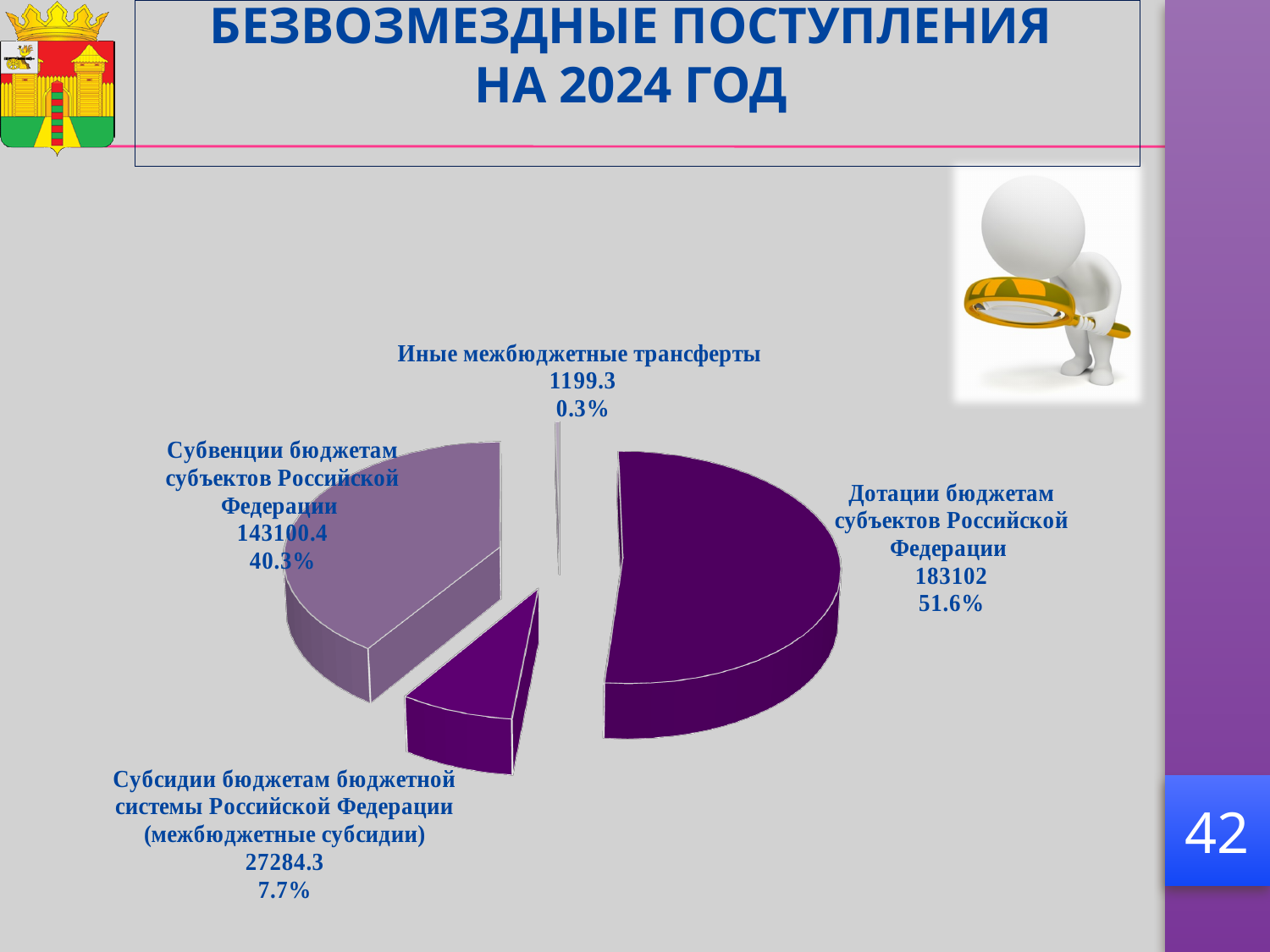
What kind of chart is shown on the slide? Pie chart Which is larger: the value for Субсидии бюджетам бюджетной системы Российской Федерации (межбюджетные субсидии) or the value for Иные межбюджетные трансферты? Субсидии бюджетам бюджетной системы Российской Федерации (межбюджетные субсидии) What share of the pie does Иные межбюджетные трансферты represent? 0.3% What is the value for Иные межбюджетные трансферты? 1199.3 What is the value for Субсидии бюджетам бюджетной системы Российской Федерации (межбюджетные субсидии)? 27284.3 How many slices does the pie chart have? 4 What share of the pie does Субвенции бюджетам субъектов Российской Федерации represent? 40.3% Which category has the smallest slice of the pie? Иные межбюджетные трансферты What is the value for Субвенции бюджетам субъектов Российской Федерации? 143100.4 What is the value for Дотации бюджетам субъектов Российской Федерации? 183102 What is the difference between the values for Дотации бюджетам субъектов Российской Федерации and Субвенции бюджетам субъектов Российской Федерации? 40001.6 Which category has the largest slice of the pie? Дотации бюджетам субъектов Российской Федерации